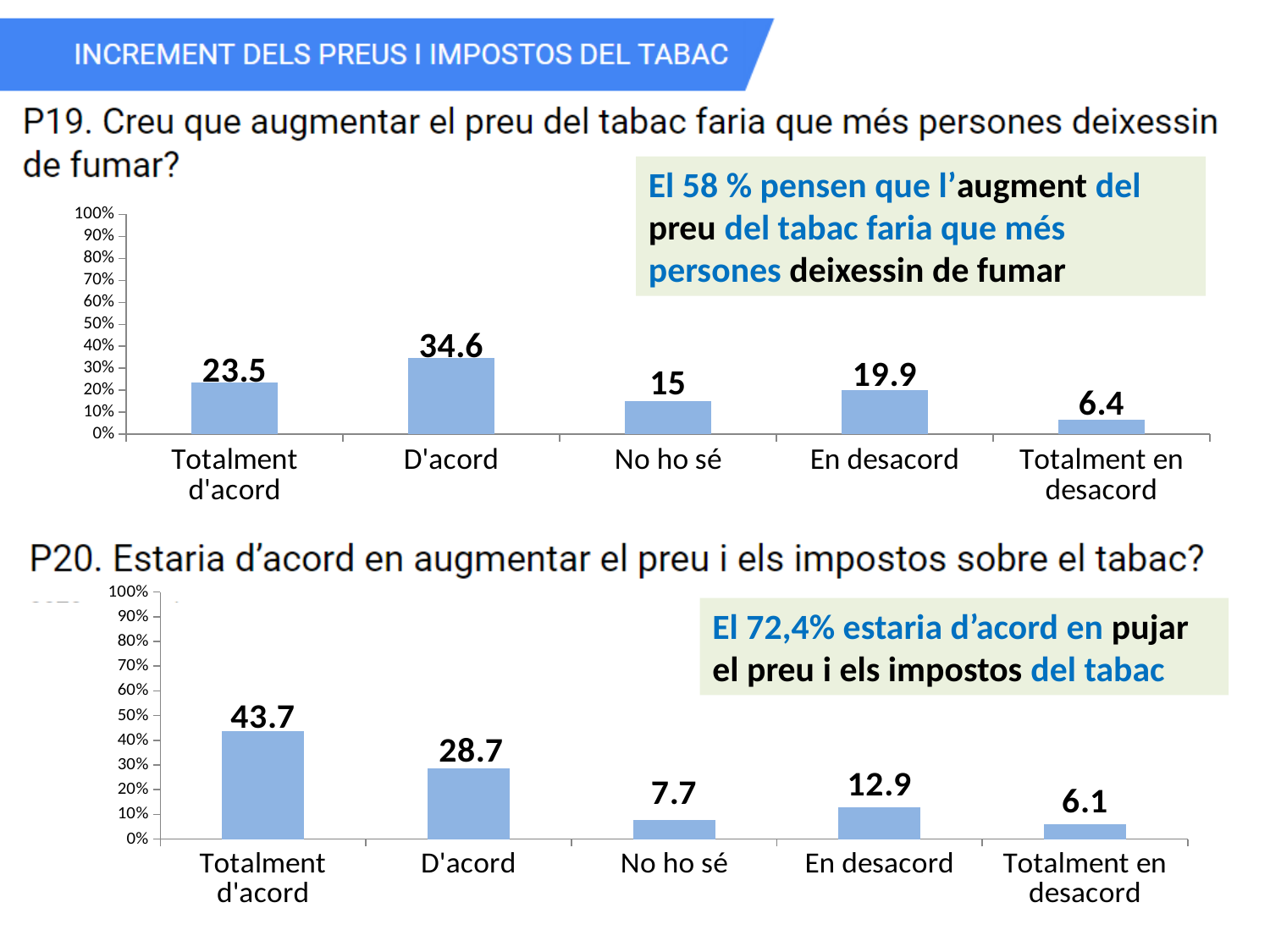
In the P20 chart (bottom), which category has the highest value? Totalment d'acord In the P19 chart (top), what is the difference between "D'acord" and "Totalment d'acord"? 11.1 In the P20 chart (bottom), what is the difference between "Totalment d'acord" and "D'acord"? 15 In the P20 chart (bottom), which is larger, "En desacord" or "No ho sé"? En desacord In the P20 chart (bottom), what is the value for "Totalment en desacord"? 6.1 How many categories are shown in the P20 chart (bottom)? 5 What kind of chart is the P19 chart (top)? Bar chart In the P19 chart (top), what is the value for "D'acord"? 34.6 In the P19 chart (top), which category has the lowest value? Totalment en desacord In the P19 chart (top), which category has the highest value? D'acord In the P20 chart (bottom), what is the value for "Totalment d'acord"? 43.7 In the P19 chart (top), what is the value for "No ho sé"? 15